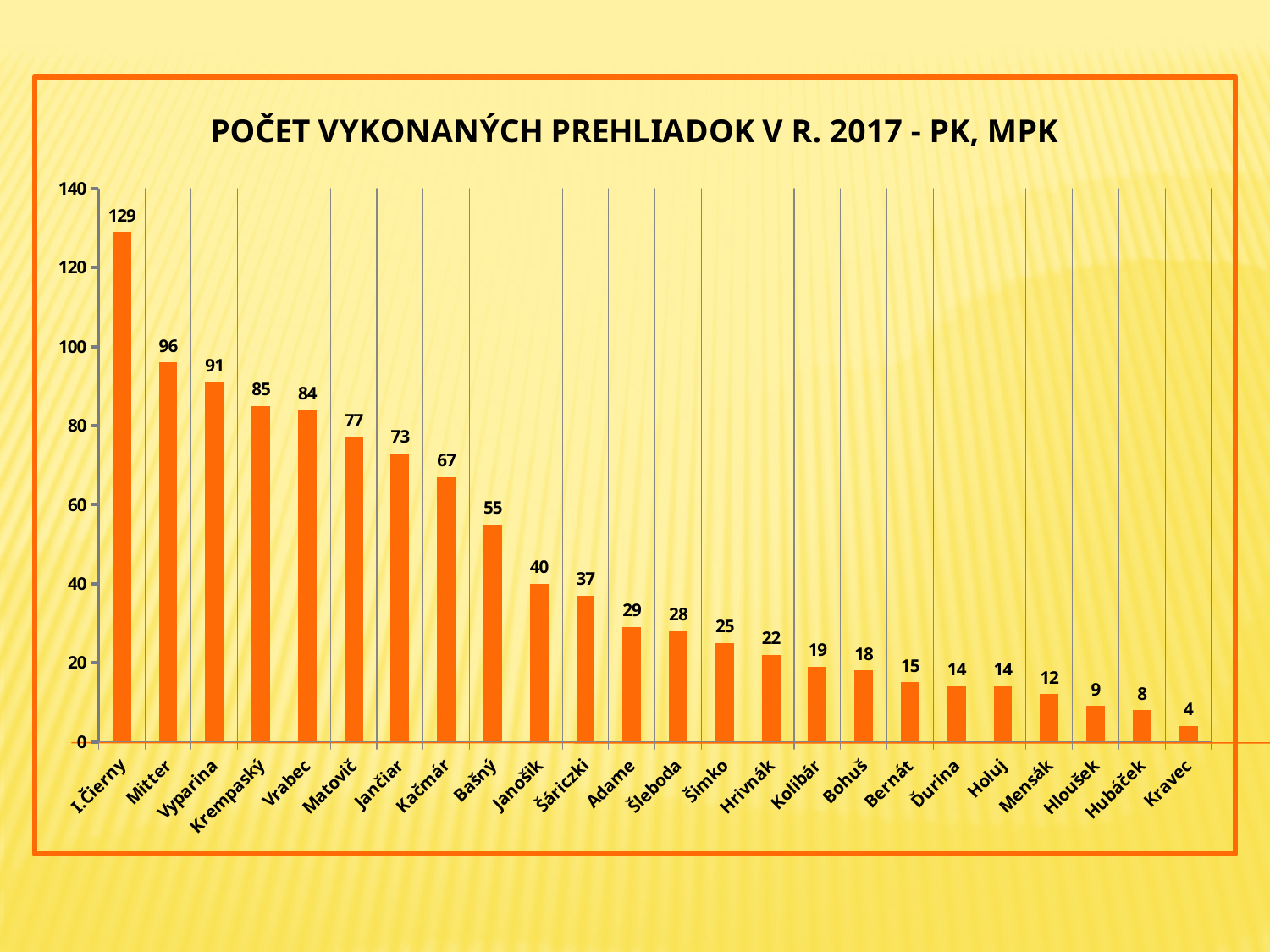
How many categories are shown on the x axis? 24 What kind of chart is this? bar chart What is the value for Šleboda? 28 Which is larger, the value for Vrabec or the value for Matovič? Vrabec What is the difference between the values for I.Čierny and Mitter? 33 What is the value for Kačmár? 67 Which category has the lowest value? Kravec What is the value for Mitter? 96 What is the title of the chart? POČET VYKONANÝCH PREHLIADOK V R. 2017 - PK, MPK Which category has the highest value? I.Čierny What is the difference between the values for Bašný and Janošík? 15 Do the values rise or fall from left to right along the x axis? fall